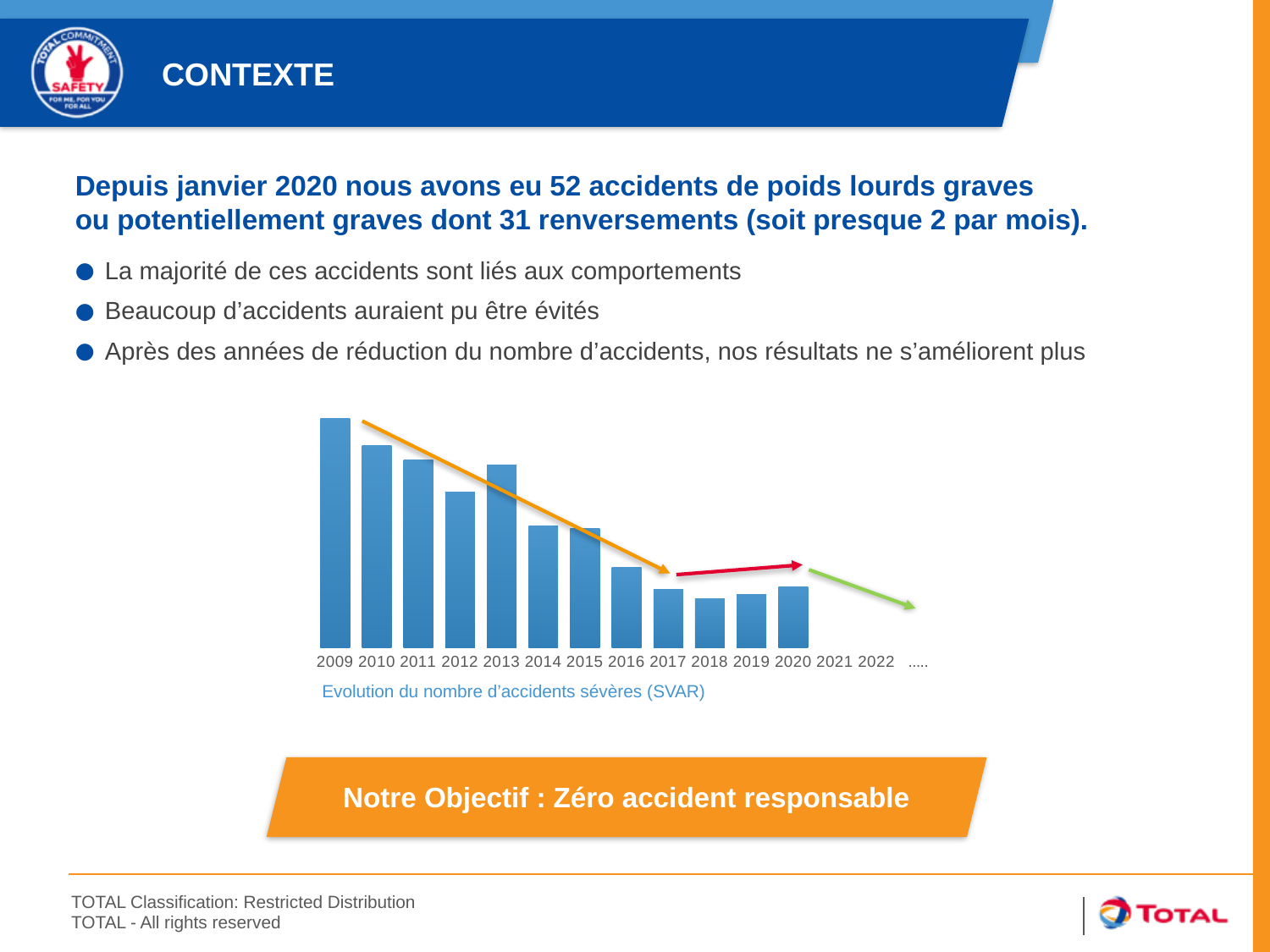
How many bars are plotted in the chart? 12 What kind of chart is shown on the slide? bar chart Which is larger, the value for 2010 or the value for 2011? 2010 Which is larger, the value for 2016 or the value for 2017? 2016 What is the caption below the chart? Evolution du nombre d'accidents sévères (SVAR) Which year is the first one with a bar in the chart? 2009 Which year is the last one with a bar in the chart? 2020 Which year has the highest bar in the chart? 2009 Do the values generally rise or fall from 2009 to 2020? fall Which is larger, the value for 2012 or the value for 2013? 2013